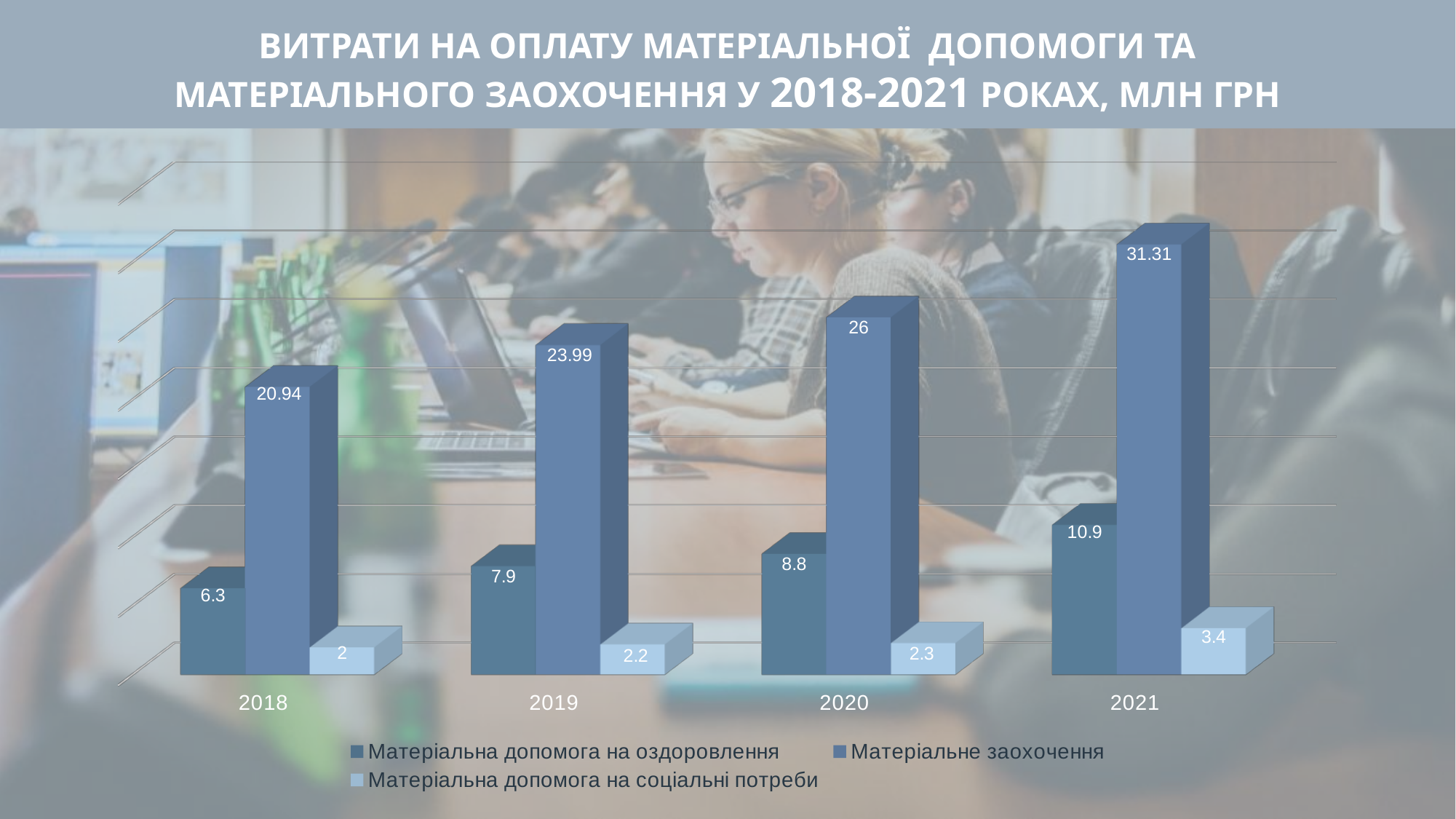
What is the value of Матеріальне заохочення in 2019? 23.99 In which year is Матеріальне заохочення the highest? 2021 What is the value of Матеріальна допомога на соціальні потреби in 2020? 2.3 What is the difference between Матеріальна допомога на оздоровлення in 2021 and in 2018? 4.6 Which is larger: Матеріальна допомога на оздоровлення in 2020 or Матеріальна допомога на соціальні потреби in 2021? Матеріальна допомога на оздоровлення in 2020 What is the value of Матеріальна допомога на оздоровлення in 2018? 6.3 What is the difference between Матеріальне заохочення in 2021 and in 2020? 5.31 What is the value of Матеріальне заохочення in 2021? 31.31 In which year is Матеріальна допомога на соціальні потреби the lowest? 2018 How many series does the legend list? 3 How many years are shown on the x axis of the chart? 4 Does Матеріальне заохочення rise or fall from 2018 to 2021? rise